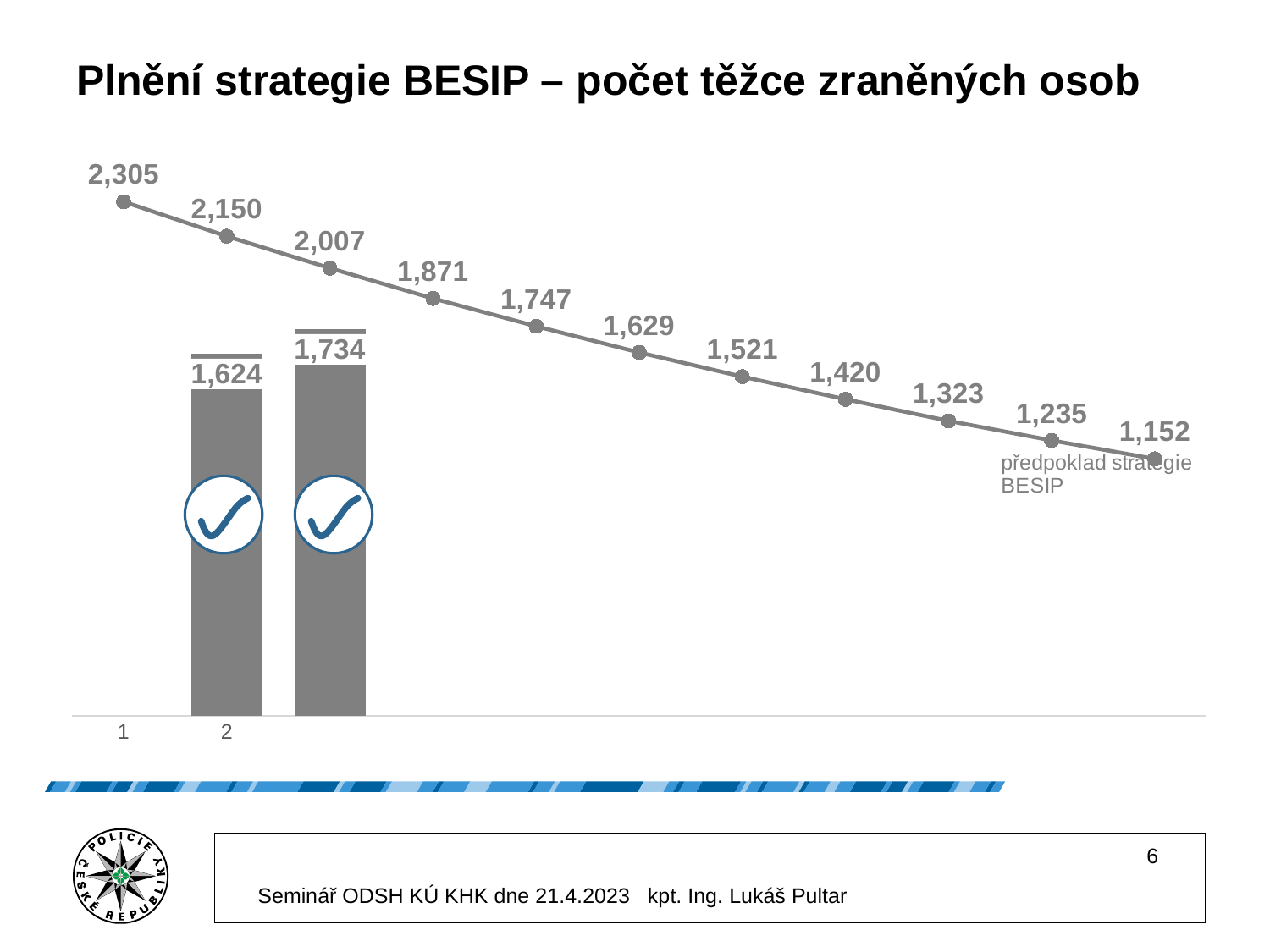
Which bar is taller, the first bar (1,624) or the second bar (1,734)? The second bar (1,734) What is the value shown on the first (left) bar? 1,624 What is the title of the chart on the slide? Plnění strategie BESIP – počet těžce zraněných osob What is the difference between the first line value (2,305) and the last line value (1,152)? 1,153 What kind of chart is shown on the slide? A combined bar and line chart What label is written next to the line series? předpoklad strategie BESIP What is the difference between the two bar values, 1,734 and 1,624? 110 What is the value shown on the second (right) bar? 1,734 What is the value of the last point on the line? 1,152 What is the value of the first point on the line? 2,305 Do the values along the line rise or fall from left to right? Fall How many data points are plotted on the line? 11